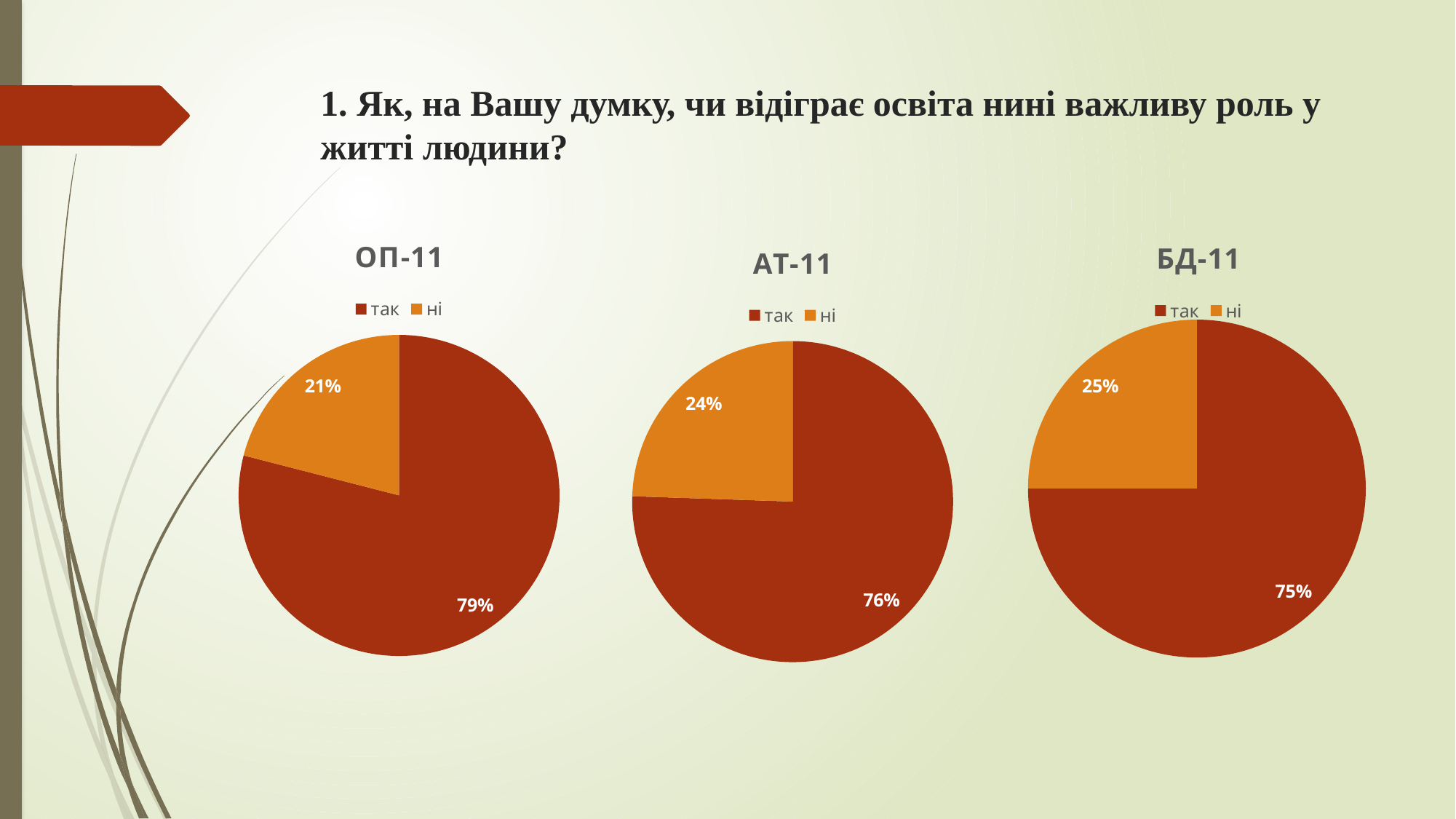
How many slices does the БД-11 pie chart have? 2 In the БД-11 chart, what percentage answered так? 75% How many entries does the legend of the ОП-11 chart list? 2 In the ОП-11 chart, what is the difference between the так and ні shares? 58% In the ОП-11 chart, what percentage answered ні? 21% Which is larger: the ні share in the ОП-11 chart or the ні share in the БД-11 chart? БД-11 In the ОП-11 chart, what percentage answered так? 79% In the АТ-11 chart, what colour is the так slice? dark red What kind of chart is the АТ-11 chart? pie chart In the АТ-11 chart, which slice is the smallest? ні In the АТ-11 chart, what percentage answered ні? 24% In the БД-11 chart, which slice is the largest? так